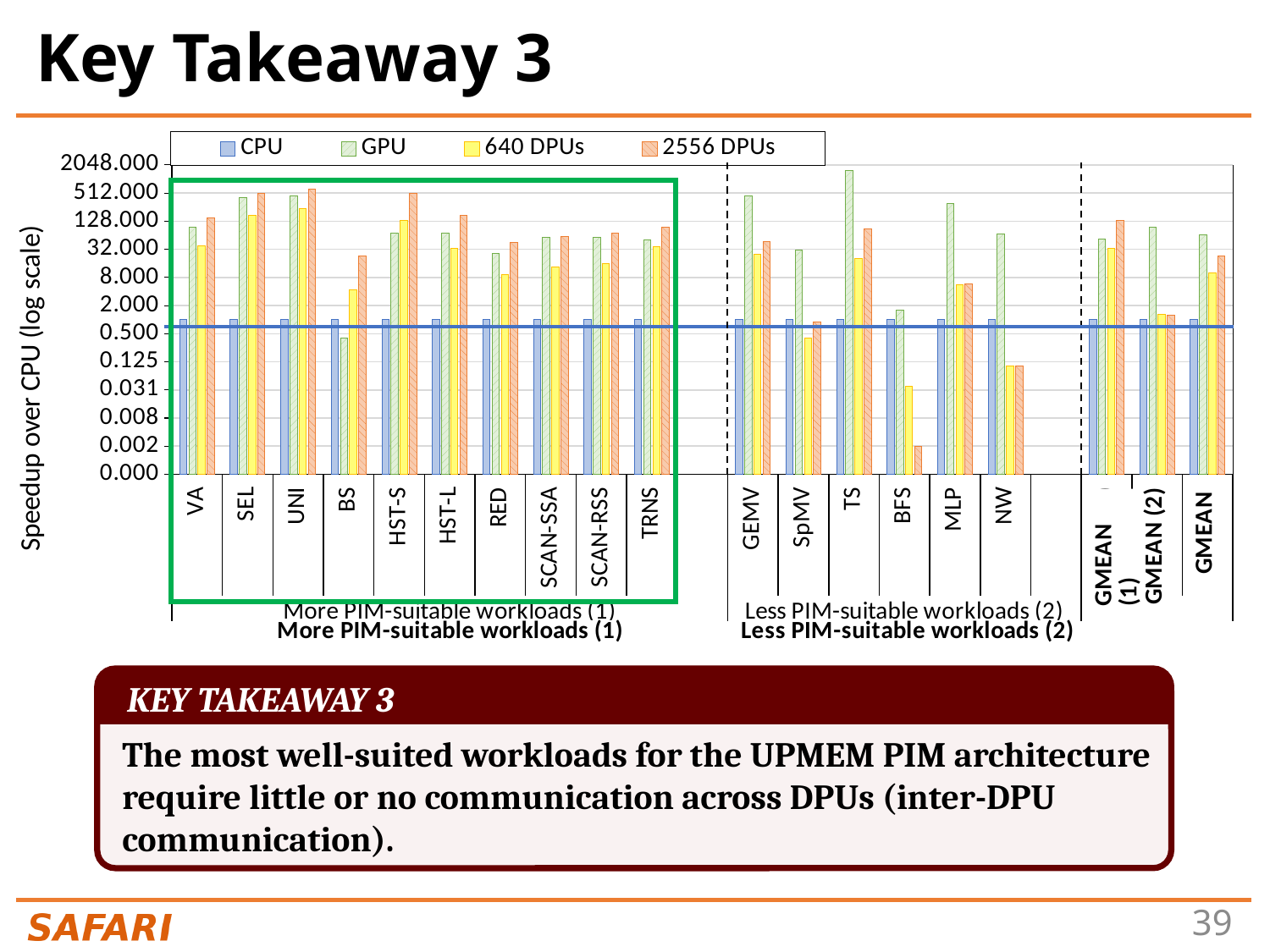
Which series does the legend list last? 2556 DPUs Is the 640 DPUs value for BFS greater or less than 0.125? less For BS, which series has the highest bar? 2556 DPUs How many series does the chart legend list? 4 How many workload categories (including the GMEAN entries) are plotted along the x axis? 19 What kind of chart is shown on the slide? bar chart Is the 2556 DPUs value for SEL greater or less than 128.000? greater For MLP, which is larger: the GPU value or the 2556 DPUs value? GPU Is the GPU value for TS greater or less than 512.000? greater Which workload has the highest GPU bar? TS What is the label of the y axis of the chart? Speedup over CPU (log scale)